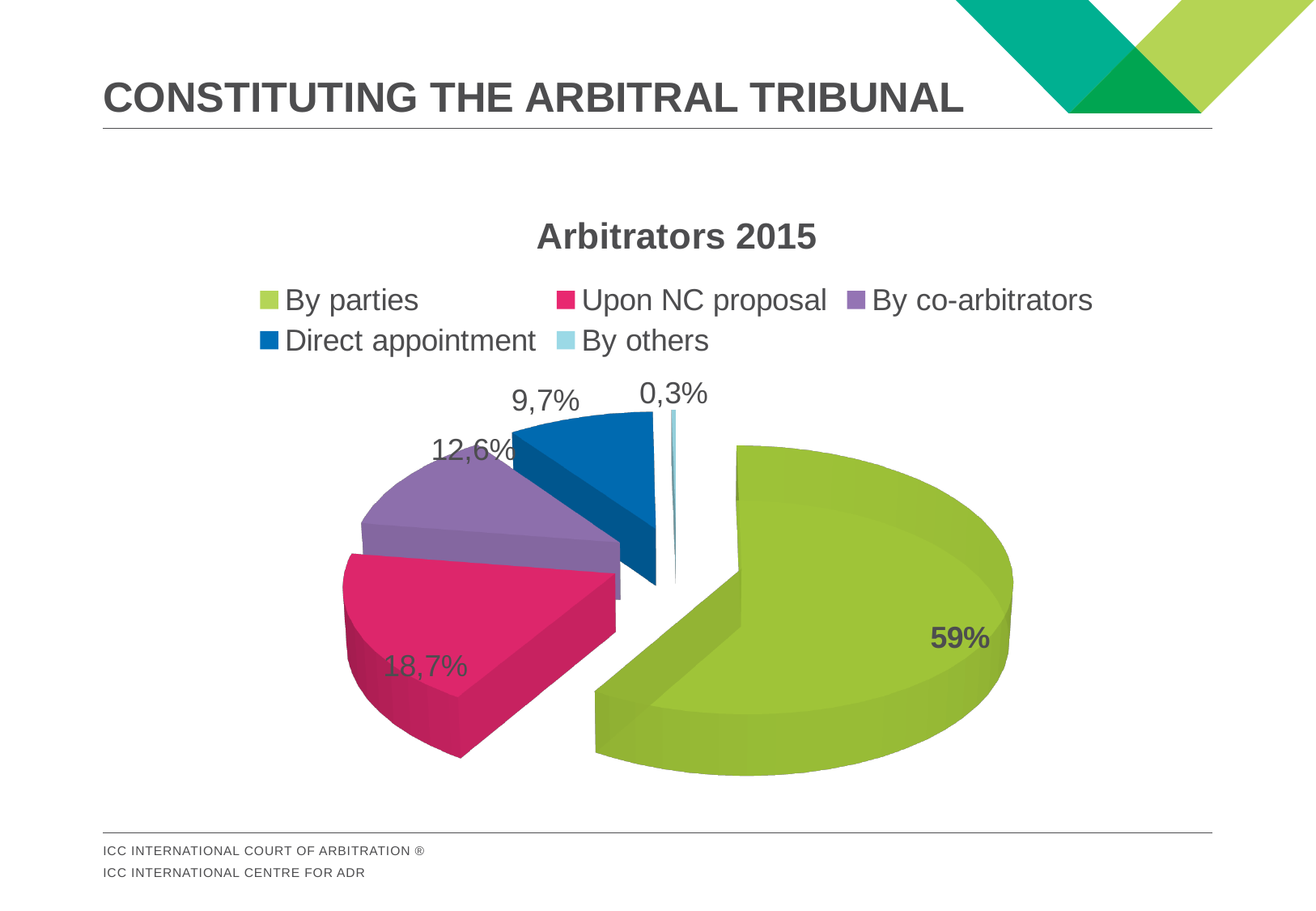
What share of arbitrators were appointed by parties? 59% What share of arbitrators were appointed by co-arbitrators? 12,6% What share of arbitrators were appointed by others? 0,3% What share of arbitrators were appointed upon NC proposal? 18,7% Which category has the largest share of the pie? By parties What is the title of the chart? Arbitrators 2015 Which is larger: the share for Upon NC proposal or the share for By co-arbitrators? Upon NC proposal What share of arbitrators were appointed by direct appointment? 9,7% What kind of chart is shown on the slide? Pie chart What is the difference in percentage points between the By co-arbitrators share and the Direct appointment share? 2,9 How many categories does the legend list? 5 Which category has the smallest share of the pie? By others